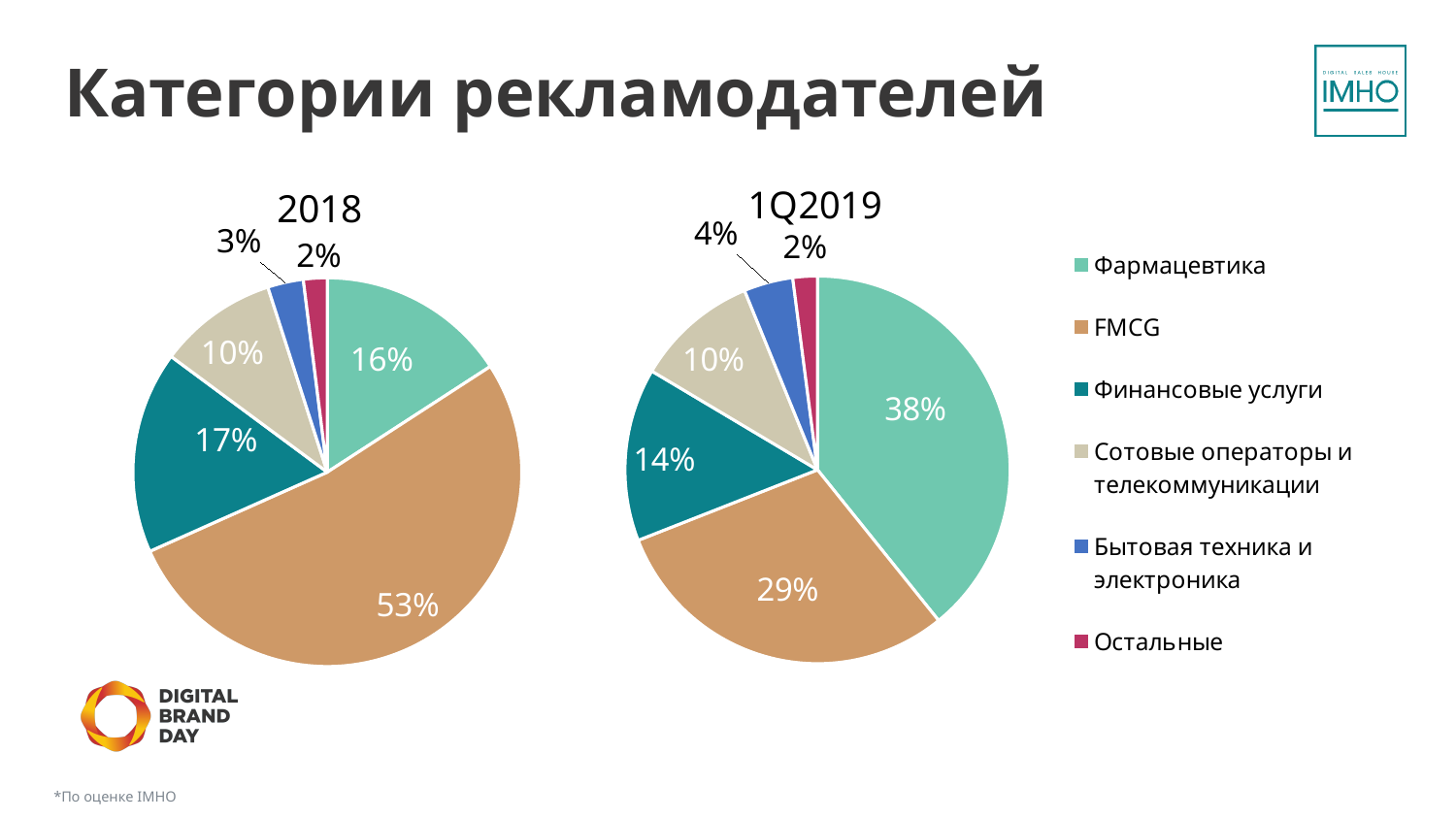
Which is larger: the Фармацевтика share in 2018 or in 1Q2019? 1Q2019 In the 2018 pie chart, which category has the largest share? FMCG What is the difference between the FMCG share in 2018 and in 1Q2019? 24 percentage points What type of chart is used on this slide? Pie chart In the 1Q2019 pie chart, what share does Фармацевтика have? 38% In the 1Q2019 pie chart, which category has the smallest share? Остальные How many categories does the legend list? 6 In the 1Q2019 pie chart, what share does Бытовая техника и электроника have? 4% What is the title of the left pie chart? 2018 In the 1Q2019 pie chart, what share does Сотовые операторы и телекоммуникации have? 10% In the 2018 pie chart, what share does FMCG have? 53% In the 2018 pie chart, what share does Финансовые услуги have? 17%